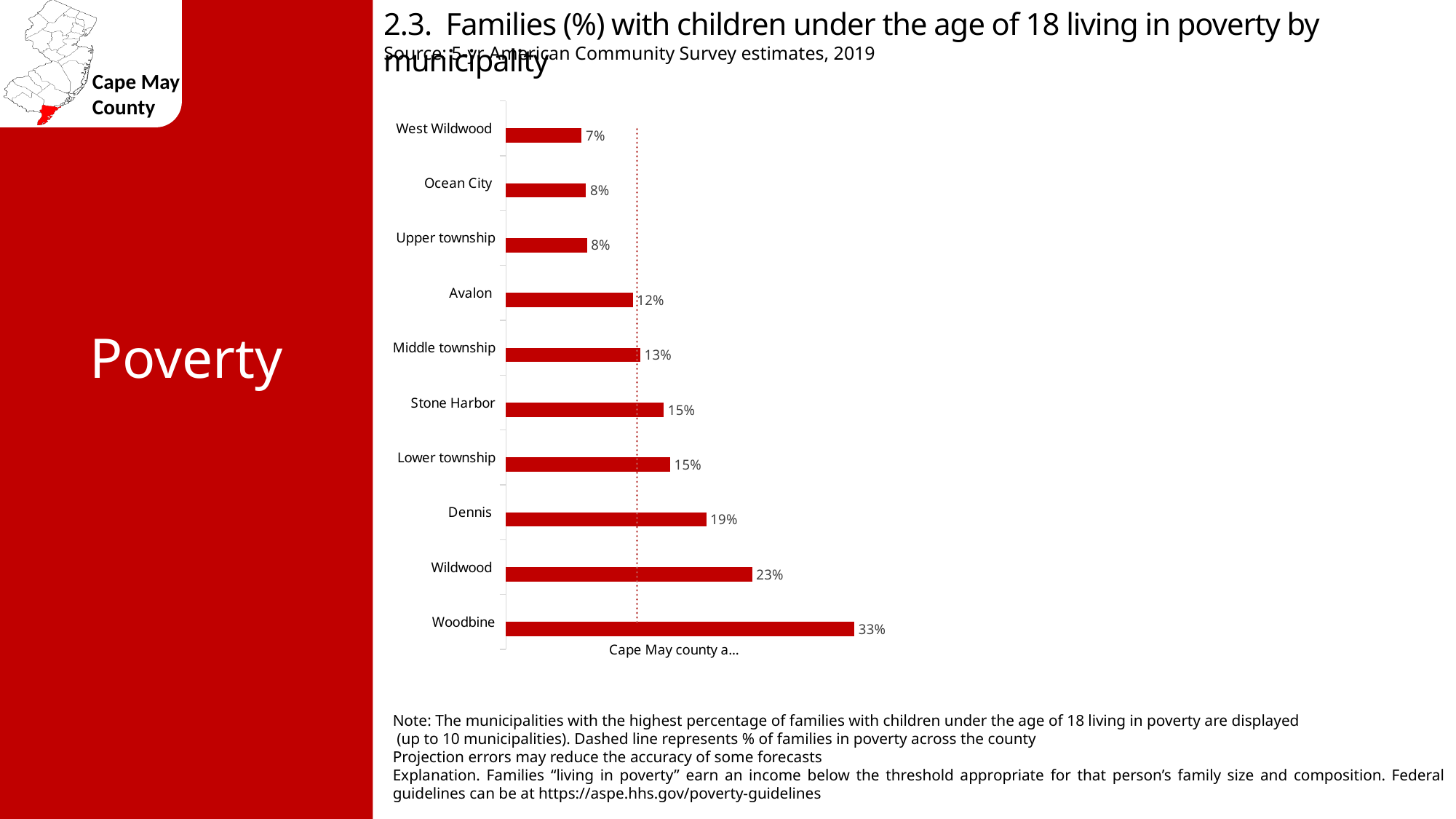
What does the dashed vertical line on the chart represent? % of families in poverty across the county What is the value shown for Middle township? 13% How many municipalities are shown on the chart? 10 Which has a higher value, Dennis or Stone Harbor? Dennis What is the value shown for West Wildwood? 7% Which municipality has the highest percentage of families with children under 18 living in poverty? Woodbine What type of chart is shown on the slide? Bar chart What is the difference between the values for Dennis and Avalon? 7% What percentage of families with children under 18 are living in poverty in Woodbine? 33% What is the difference between the values for Woodbine and Wildwood? 10% What is the value shown for Wildwood? 23% Which municipality has the lowest percentage shown on the chart? West Wildwood